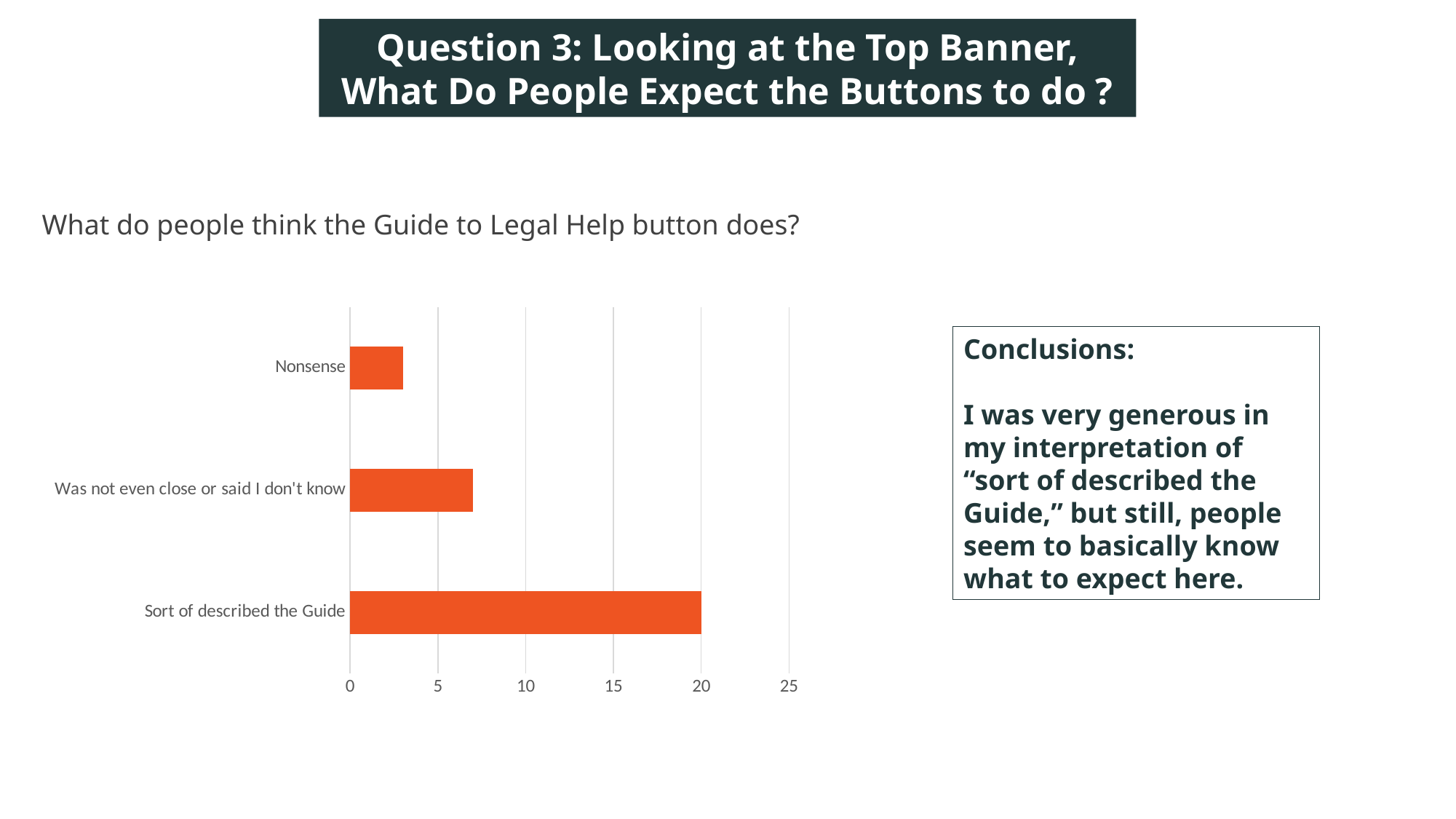
What kind of chart is shown on the slide? bar chart Which category has the lowest value? Nonsense Is the value for "Was not even close or said I don't know" greater or less than 5? greater What is the title of the chart? What do people think the Guide to Legal Help button does? Is the value for "Sort of described the Guide" greater or less than 15? greater Is the value for "Nonsense" greater or less than 5? less Which is larger, the value for "Nonsense" or the value for "Was not even close or said I don't know"? Was not even close or said I don't know What is the highest value shown on the x axis? 25 Which category has the highest value? Sort of described the Guide What is the value for "Sort of described the Guide"? 20 How many categories does the chart show? 3